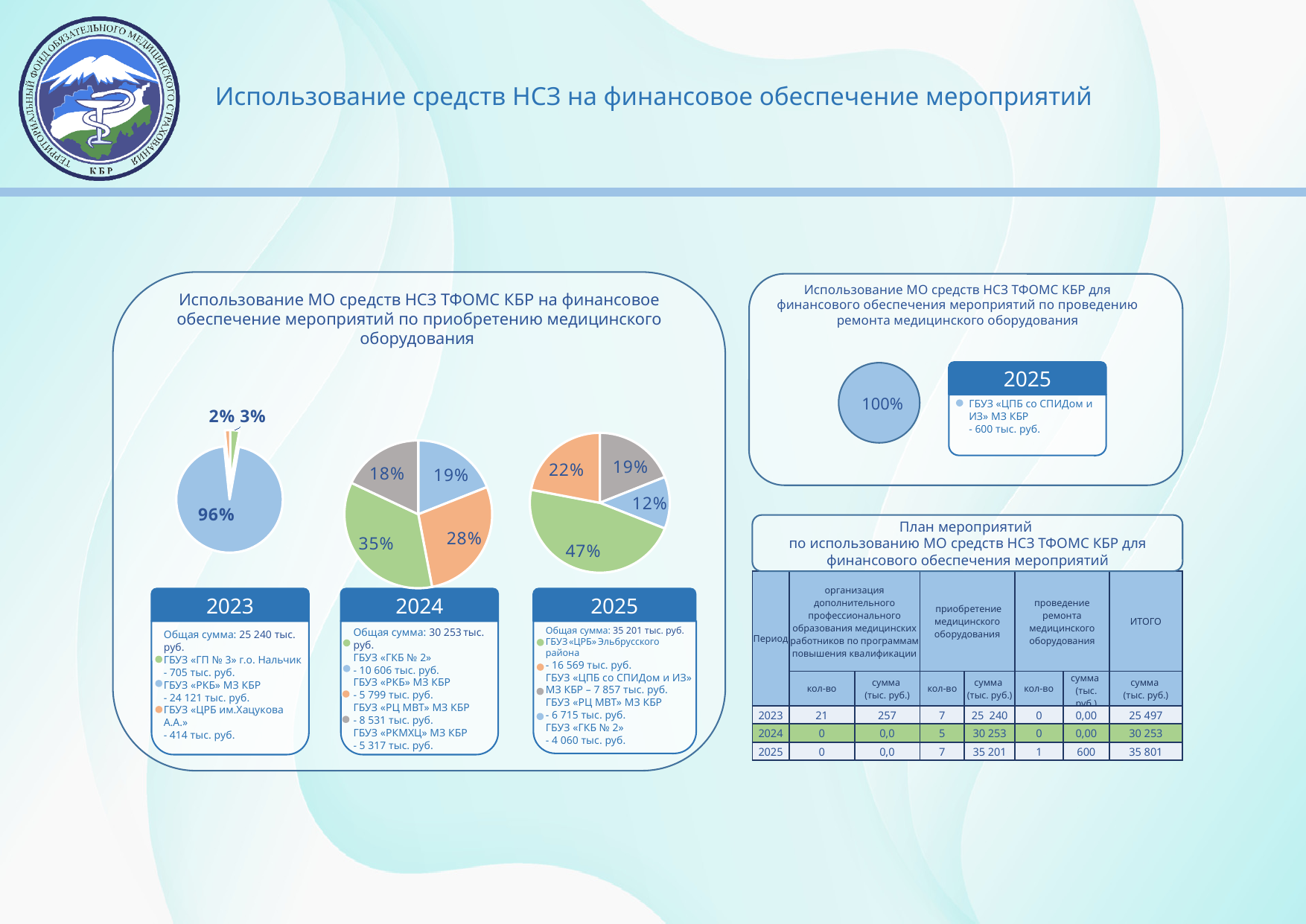
In the 2025 pie chart (left panel), what is the share of the largest slice? 47% How many slices does the 2024 pie chart have? 4 In the 2024 pie chart, what is the share of the smallest slice? 18% In the 2023 pie chart, what is the share of the largest slice? 96% What total sum (Общая сумма) is shown under the 2024 pie chart? 30 253 тыс. руб. How many slices does the 2023 pie chart have? 3 In the 2025 pie chart (left panel), which is larger: the orange slice at 22% or the gray slice at 19%? the orange slice (22%) In the chart on repair of medical equipment (top right), what percentage is shown in the circle? 100% In the 2024 pie chart, what is the difference in percentage points between the 35% slice and the 28% slice? 7 In the 2024 pie chart, what is the share of the largest slice? 35% What kind of chart is used for the 2023 data in the left panel on medical equipment purchases? pie chart In the 2025 pie chart (left panel), what is the share of the smallest slice? 12%